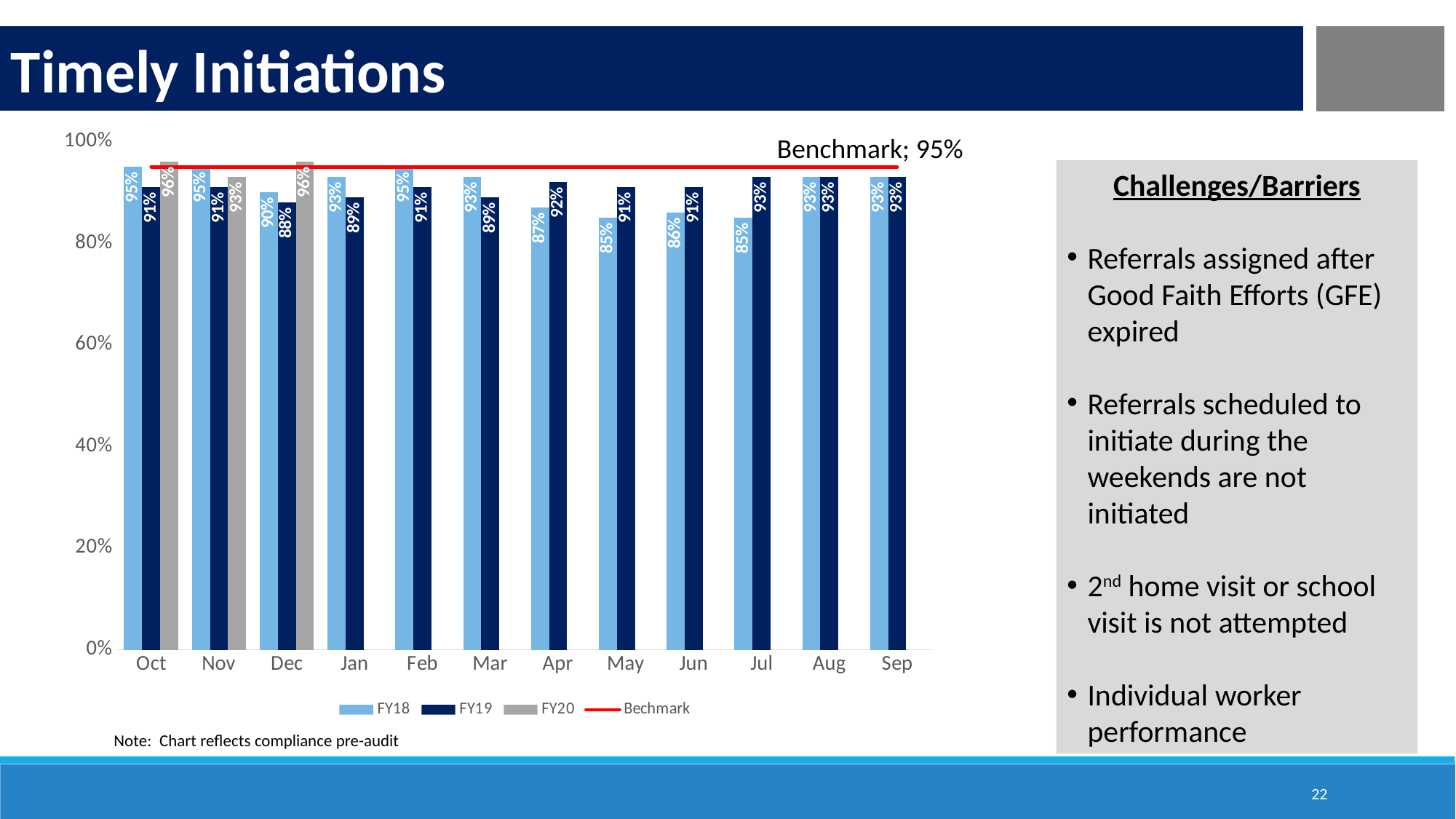
How many months are shown on the x axis? 12 What is the FY20 value for Nov? 93% Is the FY18 value for Jun greater or less than 80%? greater What is the difference between the FY18 and FY19 values for Jul? 8% Which month has the lowest FY19 value? Dec What is the FY19 value for Dec? 88% Which is larger for May, the FY18 value or the FY19 value? FY19 How many entries does the legend list? 4 What value does the benchmark line represent? 95% What kind of chart is shown on the slide? Bar chart What is the FY18 value for Apr? 87% Which months have the highest FY20 value? Oct and Dec